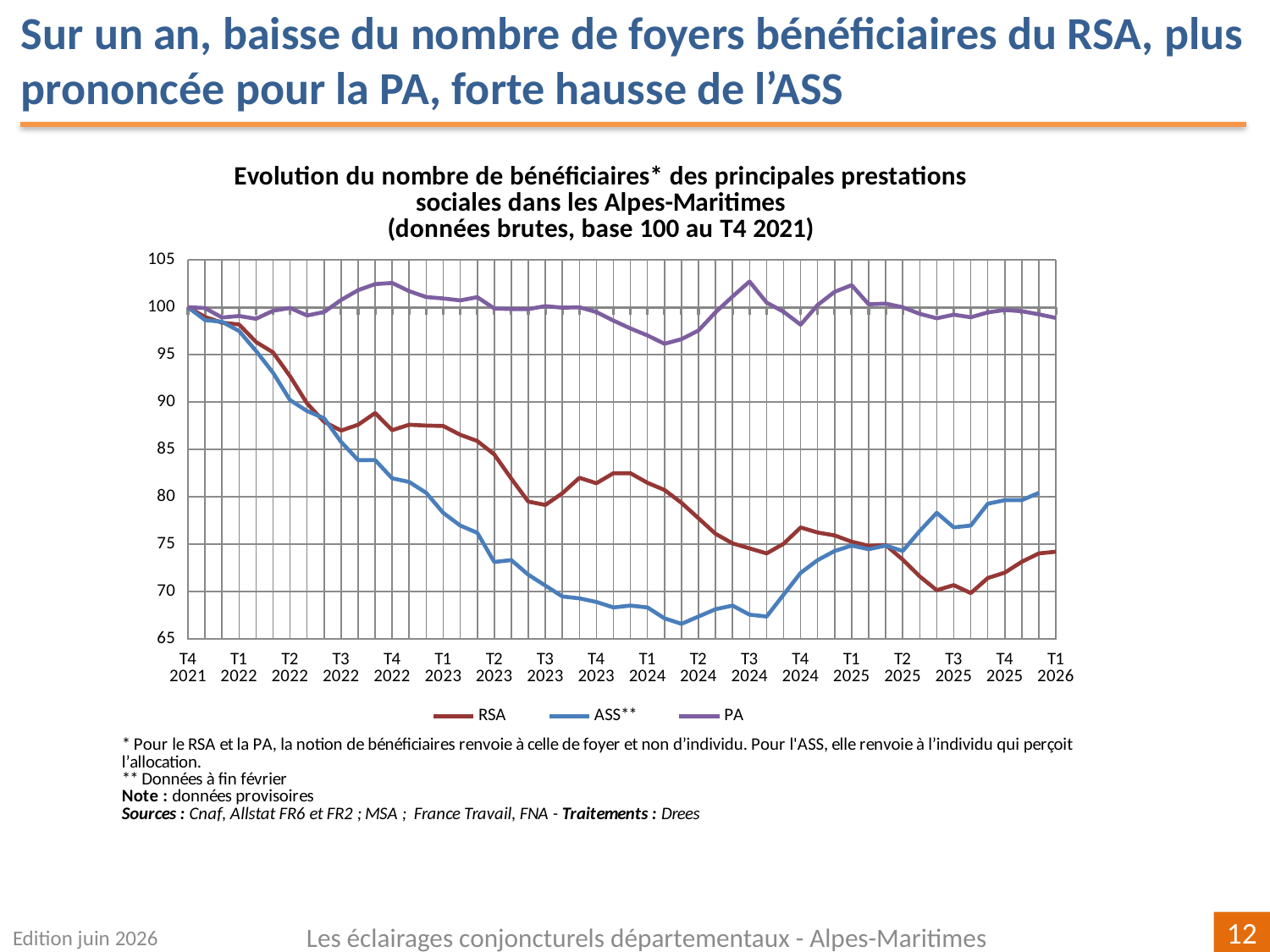
What is the value of the RSA series at T4 2021? 100 Which series are listed in the legend? RSA, ASS** and PA Is the value for ASS** at T2 2024 greater or less than 70? less Is the value for RSA at T1 2026 greater or less than 80? less Is the value for PA at T3 2024 greater or less than 100? greater At T1 2023, which series has the higher value, RSA or ASS**? RSA How many quarters are shown on the x axis? 18 Which series has the lowest value at T3 2024? ASS** Does the ASS** series rise or fall between T4 2021 and T2 2024? fall What kind of chart is shown on the slide? line chart How many series does the legend list? 3